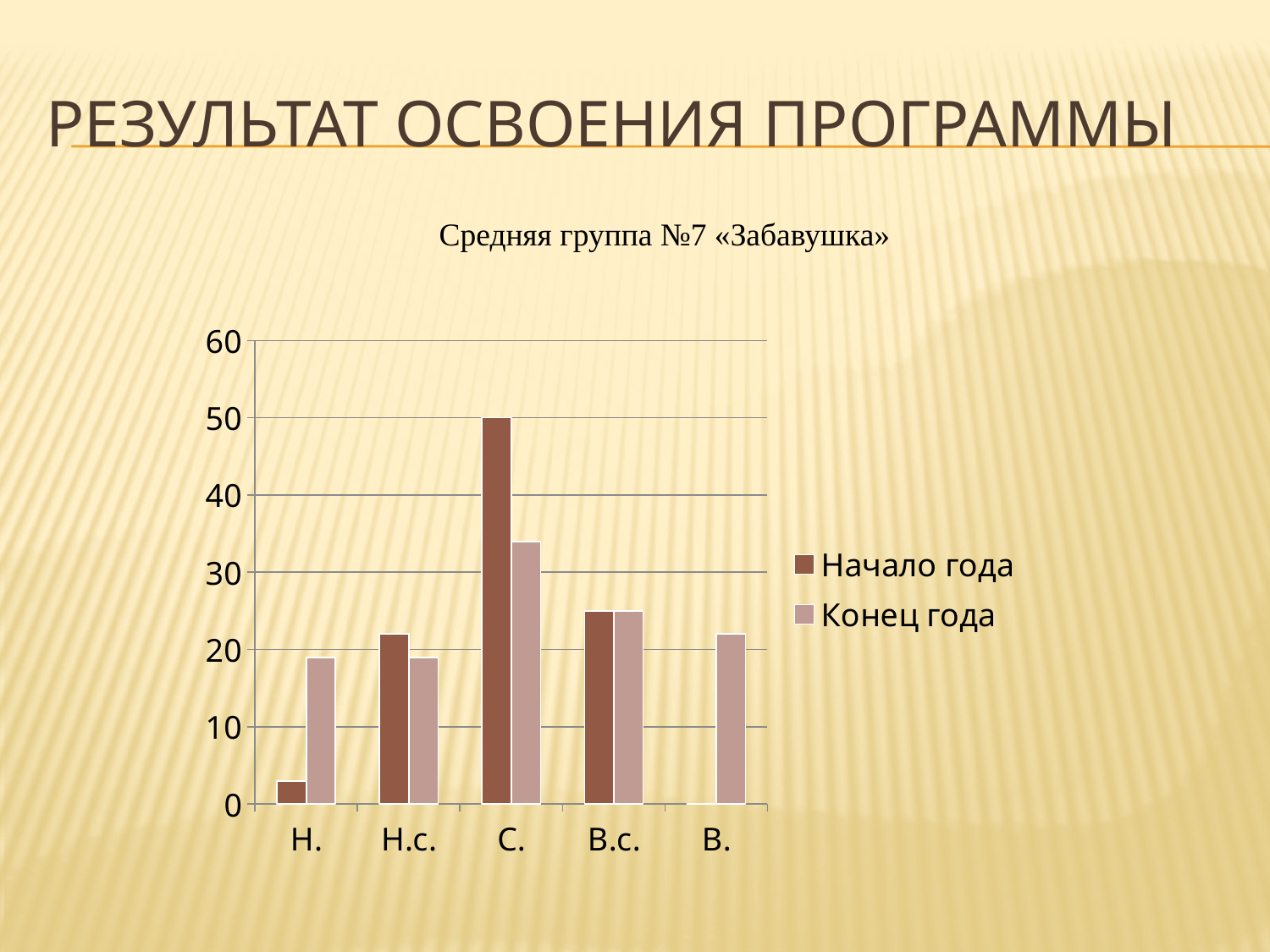
What is the value for С. in the Начало года series? 50 Is the value for С. in the Конец года series greater or less than 40? less Which category has the lowest value in the Начало года series? В. For Н., which series has the larger value, Начало года or Конец года? Конец года For С., which series has the larger value, Начало года or Конец года? Начало года Which category has the highest value in the Конец года series? С. What kind of chart is shown on the slide? bar chart How many categories are shown on the x axis? 5 How many series does the legend list? 2 Is the value for Н. in the Конец года series greater or less than 10? greater Which category has the highest value in the Начало года series? С. What is the subtitle shown above the chart? Средняя группа №7 «Забавушка»